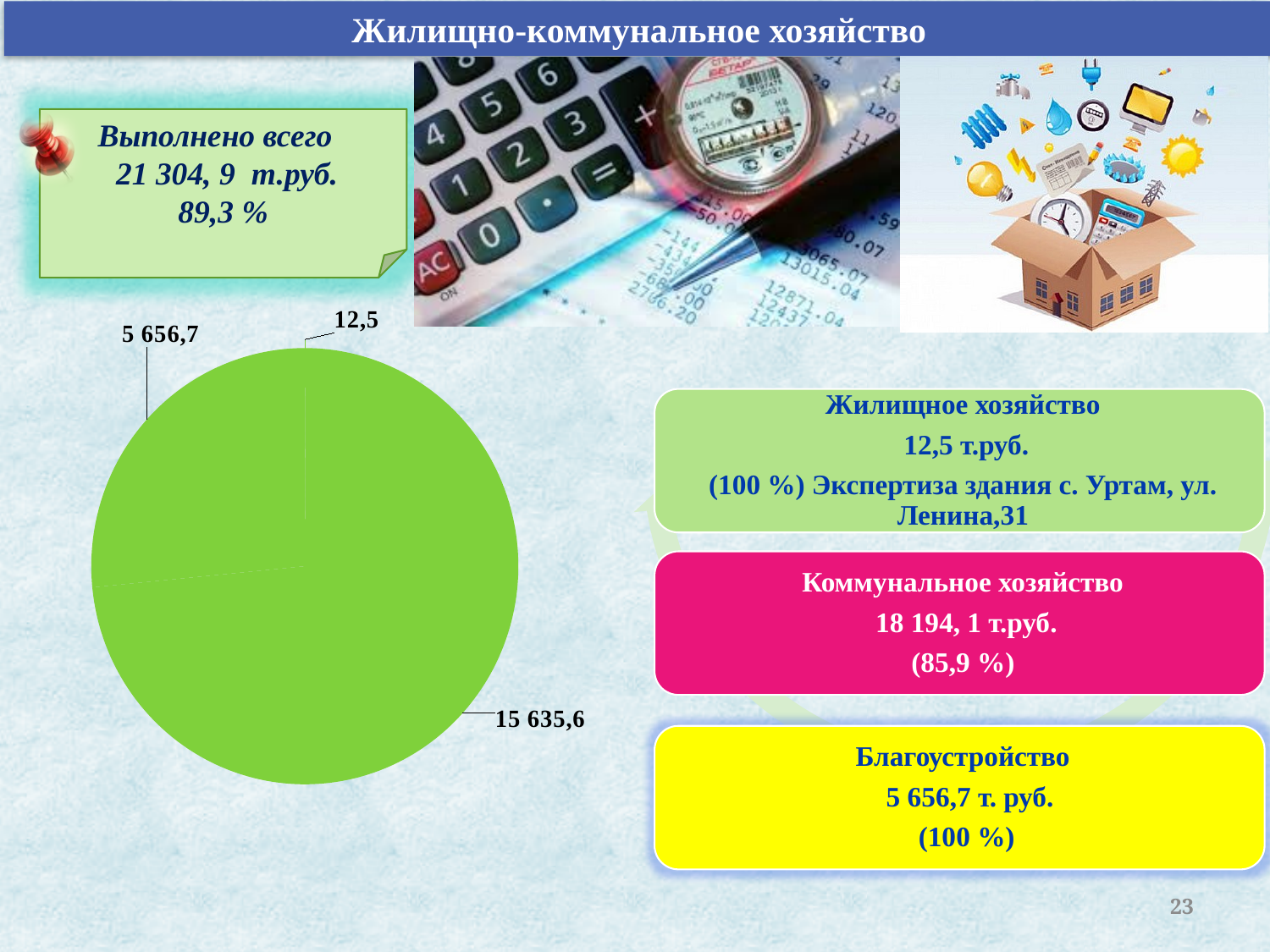
What is the value of the largest slice in the pie chart? 15 635,6 How many slices does the pie chart have? 3 What is the value of the smallest slice in the pie chart? 12,5 What kind of chart is shown on the slide? pie chart Which is larger in the pie chart: the slice labelled 5 656,7 or the slice labelled 15 635,6? 15 635,6 What is the difference between the slice labelled 5 656,7 and the slice labelled 12,5? 5 644,2 What is the difference between the slice labelled 15 635,6 and the slice labelled 5 656,7? 9 978,9 What colour are the slices of the pie chart? green Does the pie chart have a legend? No What is the data label on the slice at the lower right of the pie chart? 15 635,6 What is the data label on the slice at the upper left of the pie chart? 5 656,7